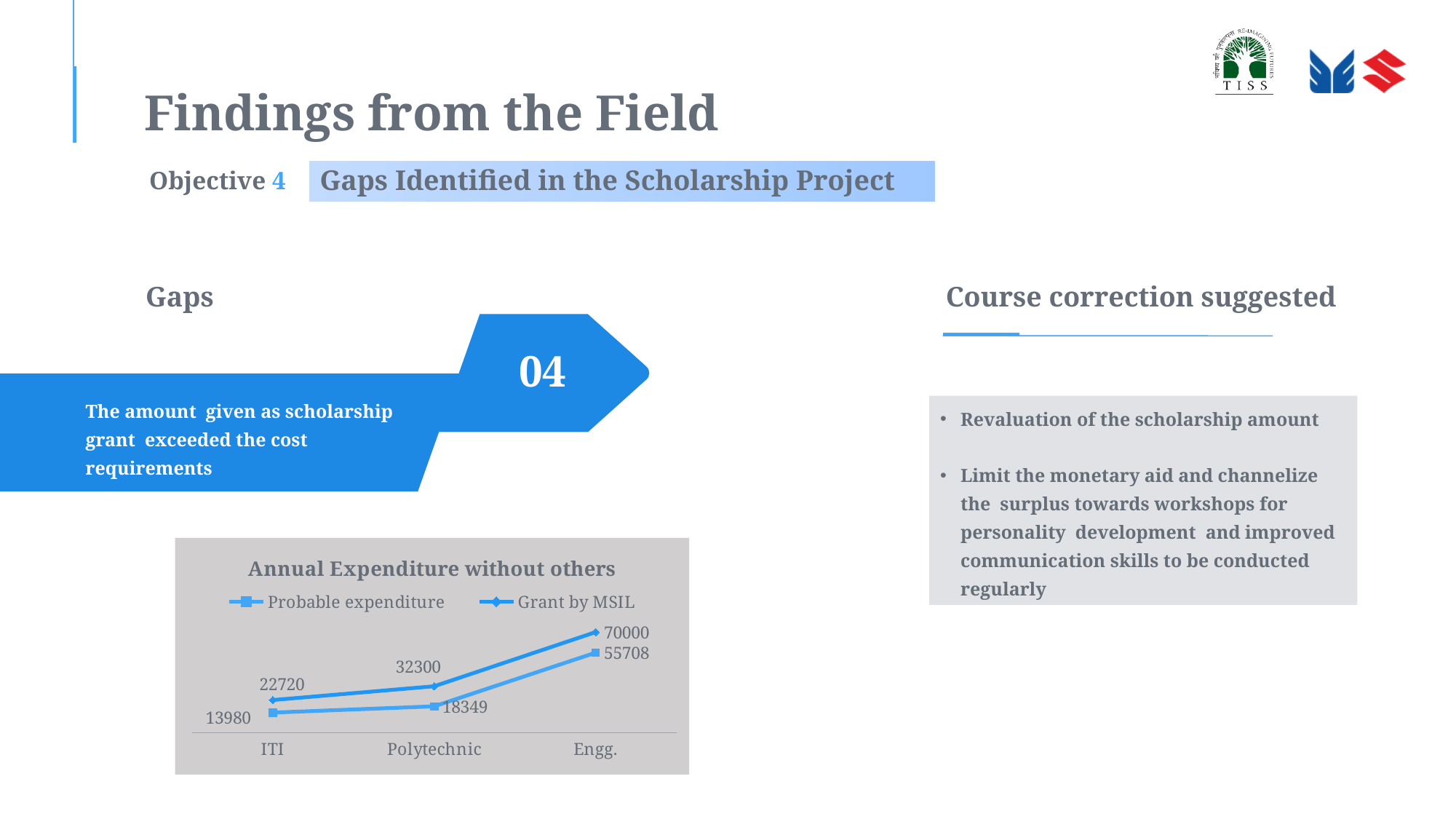
Which category has the lowest Grant by MSIL value? ITI What type of chart is shown on the slide? line chart What is the Probable expenditure value for Polytechnic? 18349 What is the Probable expenditure value for ITI? 13980 How many categories are shown on the x axis of the chart? 3 What is the Grant by MSIL value for Engg.? 70000 What is the Grant by MSIL value for Polytechnic? 32300 What is the title of the chart? Annual Expenditure without others Does the Probable expenditure rise or fall from ITI to Engg.? rise How many series does the chart's legend list? 2 Which category has the highest Probable expenditure? Engg. What is the difference between the Grant by MSIL and the Probable expenditure for Engg.? 14292